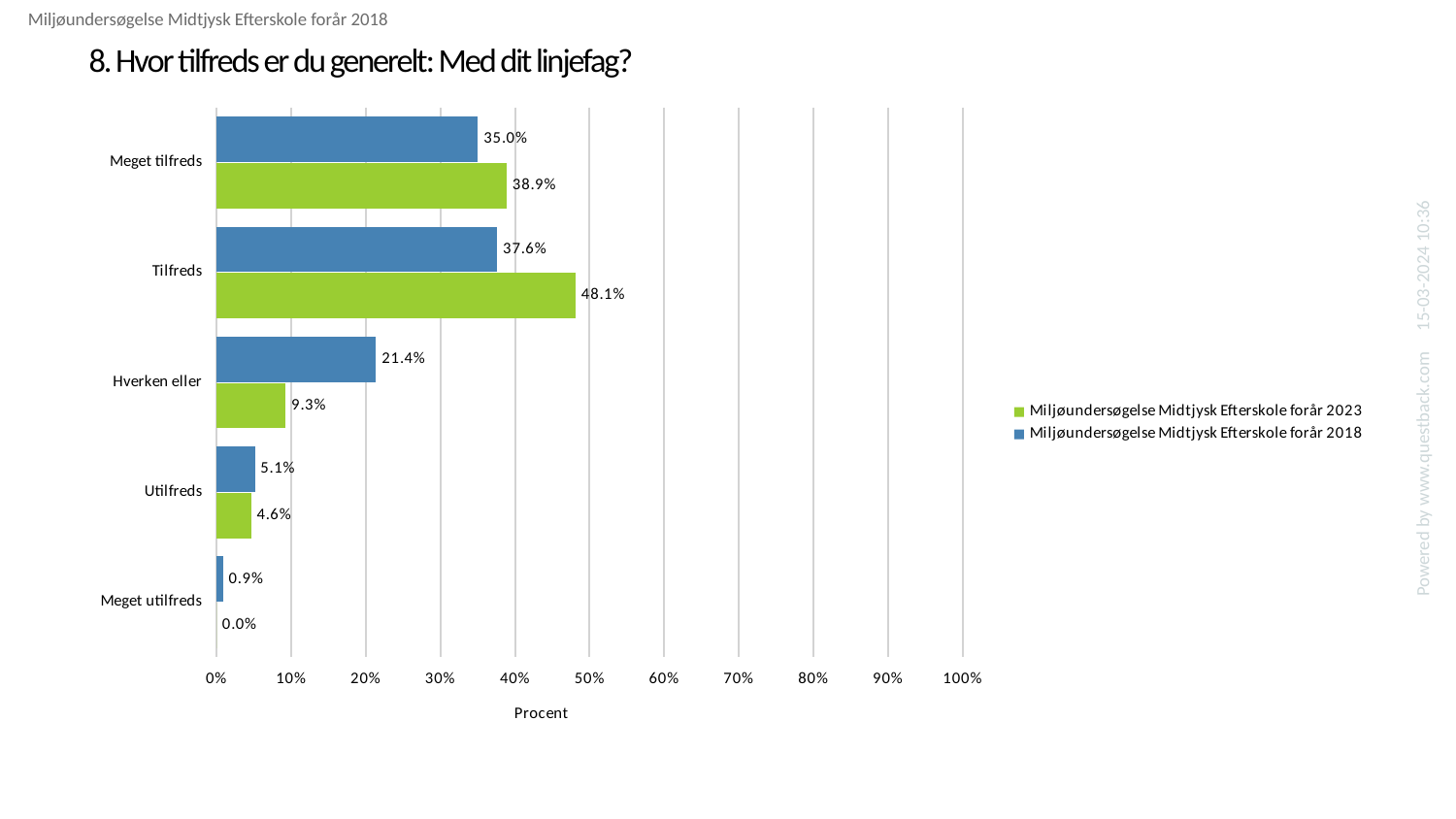
How many series does the legend list? 2 Is the 2023 value for Meget tilfreds greater or less than 30%? greater Which category has the highest value in the 2023 series? Tilfreds How many categories are shown on the chart? 5 What is the value for Tilfreds in the Miljøundersøgelse Midtjysk Efterskole forår 2023 series? 48.1% What kind of chart is shown on the slide? Bar chart What is the difference between the 2018 and 2023 values for Hverken eller? 12.1% What is the difference between the 2023 and 2018 values for Tilfreds? 10.5% What is the value for Hverken eller in the Miljøundersøgelse Midtjysk Efterskole forår 2018 series? 21.4% Which category has the lowest value in the 2018 series? Meget utilfreds Which series has the larger value for Utilfreds, 2018 or 2023? 2018 What is the value for Meget tilfreds in the 2018 series? 35.0%